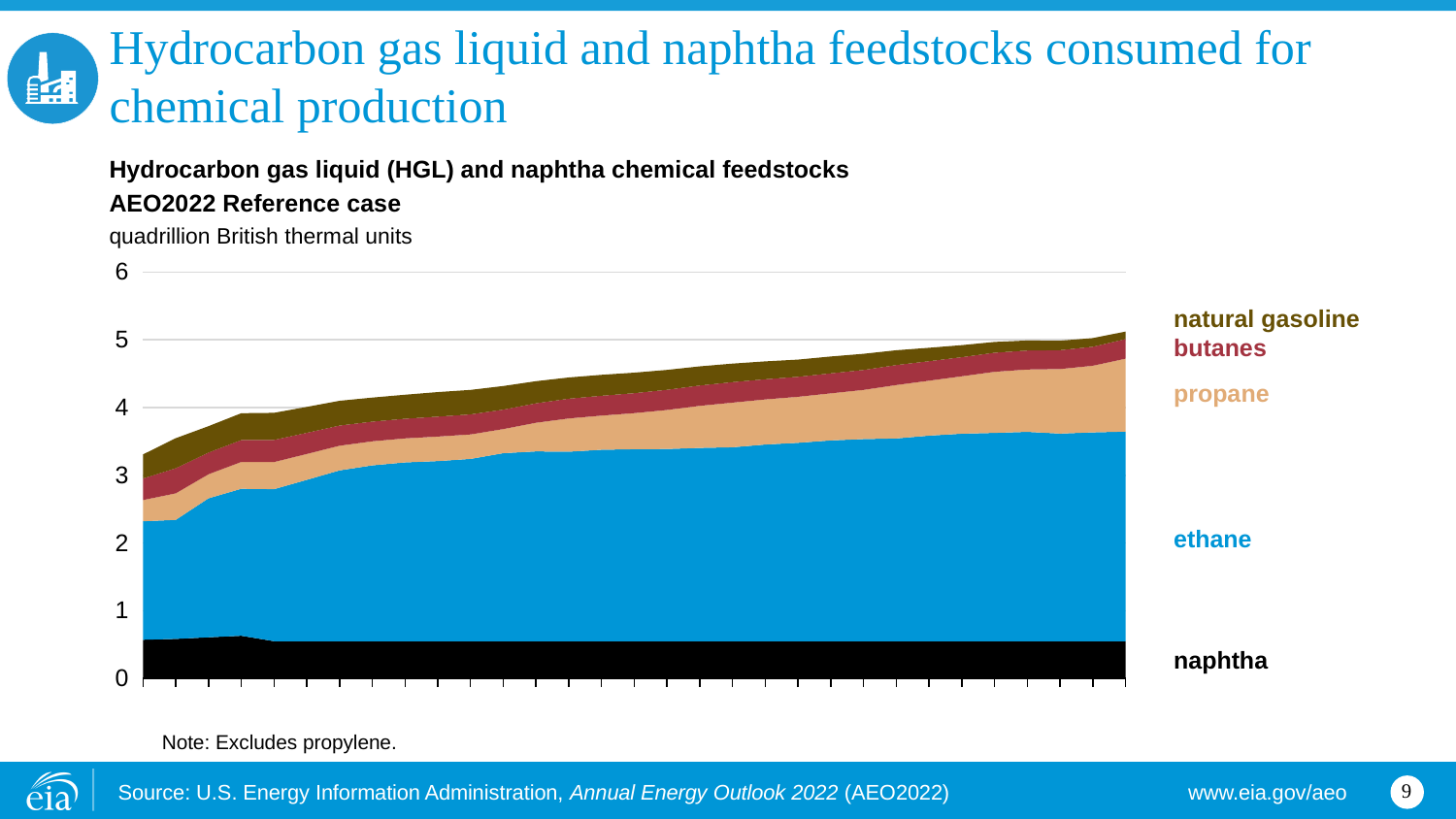
Is the total of all feedstocks at the right end of the chart greater or less than 4? greater Is the total of all feedstocks at the left end of the chart greater or less than 4? less Does the total of all feedstocks rise or fall from left to right along the x axis? rise How many feedstock series are labeled on the chart? 5 Which is larger at the right end of the chart, the ethane band or the propane band? ethane Is the total of all feedstocks at the left end of the chart greater or less than 3? greater Which AEO2022 case does the chart show? Reference case Which feedstock accounts for the largest share of the stacked total throughout the chart? ethane What unit is used on the chart's vertical axis? quadrillion British thermal units Which series is plotted at the bottom of the stack? naphtha What kind of chart is shown on the slide? stacked area chart